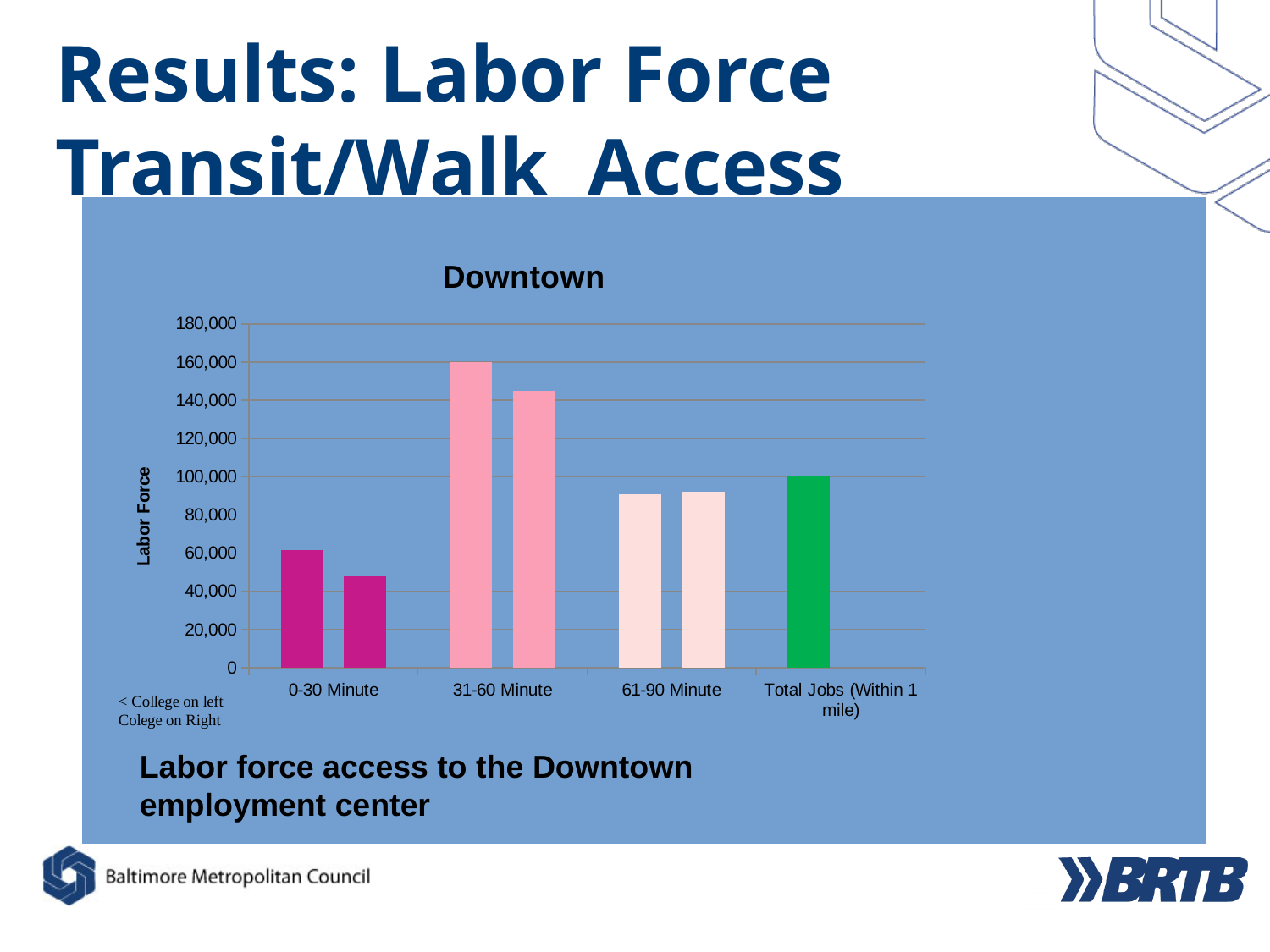
How many categories are shown along the x axis of the chart? 4 What is the title of the chart? Downtown Is the value of the left bar for 61-90 Minute greater or less than 80,000? greater Is the value of the left bar for 31-60 Minute greater or less than 140,000? greater Which is larger: the left bar for 31-60 Minute or the left bar for 61-90 Minute? 31-60 Minute Which category has the tallest bar in the chart? 31-60 Minute Is the value of the Total Jobs (Within 1 mile) bar greater or less than 120,000? less For the 0-30 Minute category, which bar is larger, the left one or the right one? the left one What kind of chart is shown on the slide? bar chart What is the label on the vertical axis of the chart? Labor Force Which category has the shortest bar in the chart? 0-30 Minute